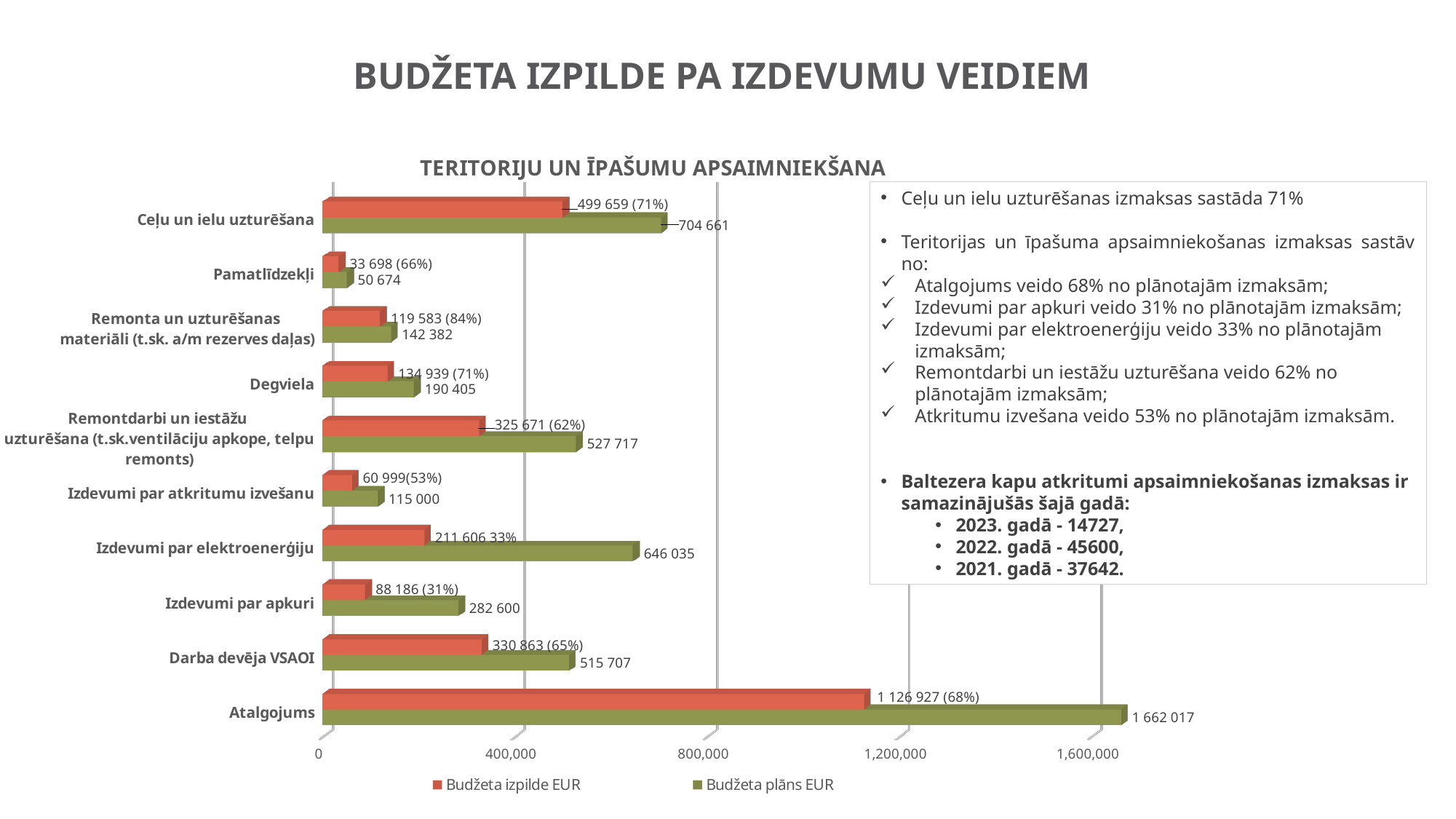
What is the Budžeta plāns EUR value for Izdevumi par elektroenerģiju? 646 035 What type of chart is shown on the slide? bar chart What is the Budžeta izpilde EUR value for Izdevumi par apkuri? 88 186 What is the title of the chart? TERITORIJU UN ĪPAŠUMU APSAIMNIEKŠANA Which category has the highest Budžeta plāns EUR value? Atalgojums What is the difference between the Budžeta plāns EUR and Budžeta izpilde EUR values for Degviela? 55 466 How many categories are shown on the chart? 10 Is the Budžeta plāns EUR value for Ceļu un ielu uzturēšana greater or less than 800,000? less Which is larger: the Budžeta izpilde EUR value for Darba devēja VSAOI or for Remontdarbi un iestāžu uzturēšana? Darba devēja VSAOI What is the Budžeta plāns EUR value for Atalgojums? 1 662 017 Which category has the lowest Budžeta izpilde EUR value? Pamatlīdzekļi How many series does the chart legend list? 2